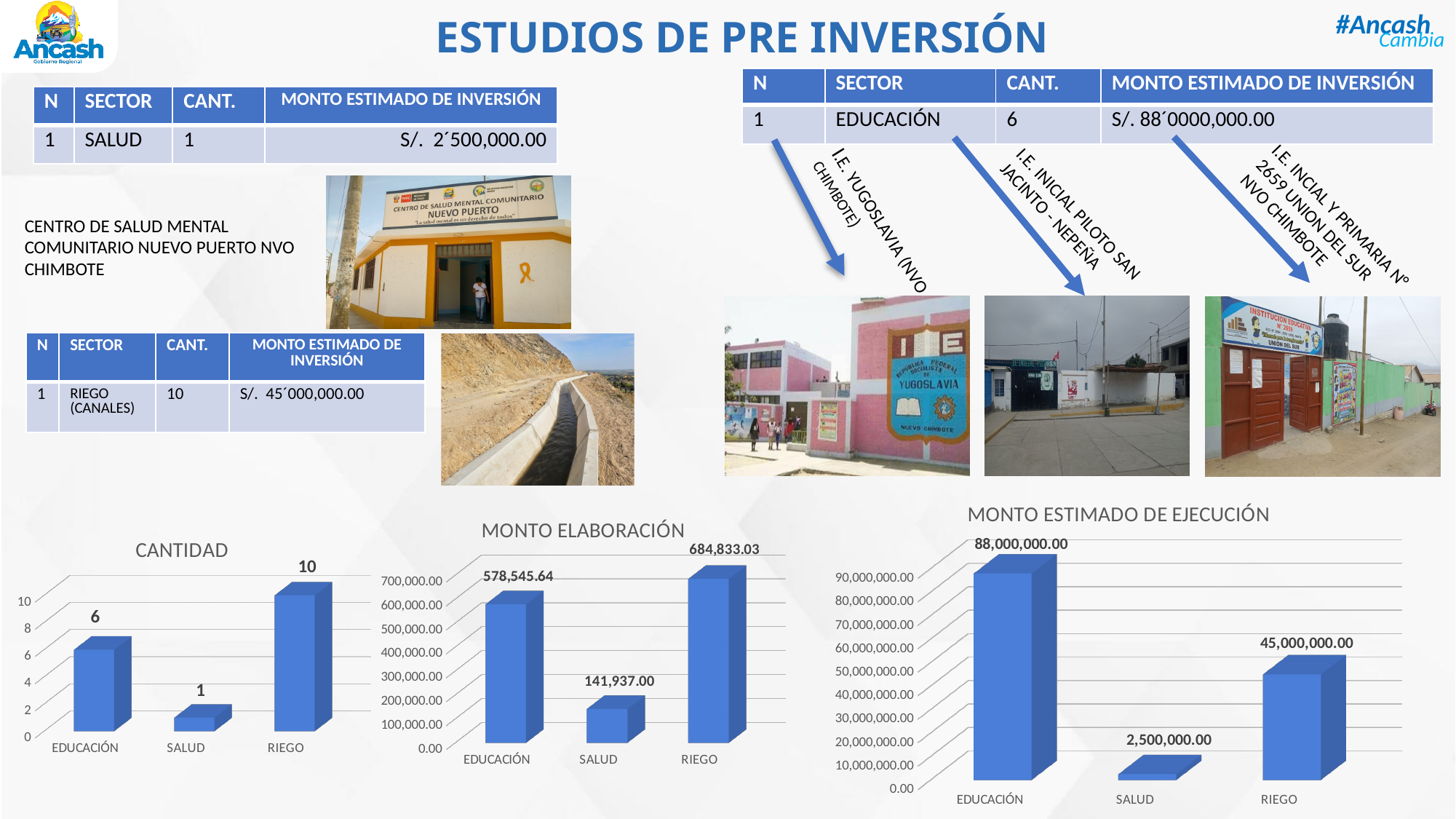
In the MONTO ESTIMADO DE EJECUCIÓN chart, what is the value for EDUCACIÓN? 88,000,000.00 In the MONTO ELABORACIÓN chart, what is the value for EDUCACIÓN? 578,545.64 In the MONTO ELABORACIÓN chart, what is the value for SALUD? 141,937.00 In the CANTIDAD chart, which category has the lowest value? SALUD What type of chart is the CANTIDAD chart? Bar chart In the MONTO ESTIMADO DE EJECUCIÓN chart, what is the difference between the values for EDUCACIÓN and RIEGO? 43,000,000.00 In the CANTIDAD chart, what is the difference between the values for RIEGO and EDUCACIÓN? 4 In the MONTO ESTIMADO DE EJECUCIÓN chart, which is larger, the value for RIEGO or the value for SALUD? RIEGO In the MONTO ELABORACIÓN chart, is the value for RIEGO greater or less than 600,000.00? greater In the MONTO ELABORACIÓN chart, which category has the highest value? RIEGO How many categories are shown in the MONTO ESTIMADO DE EJECUCIÓN chart? 3 In the CANTIDAD chart, what is the value for RIEGO? 10